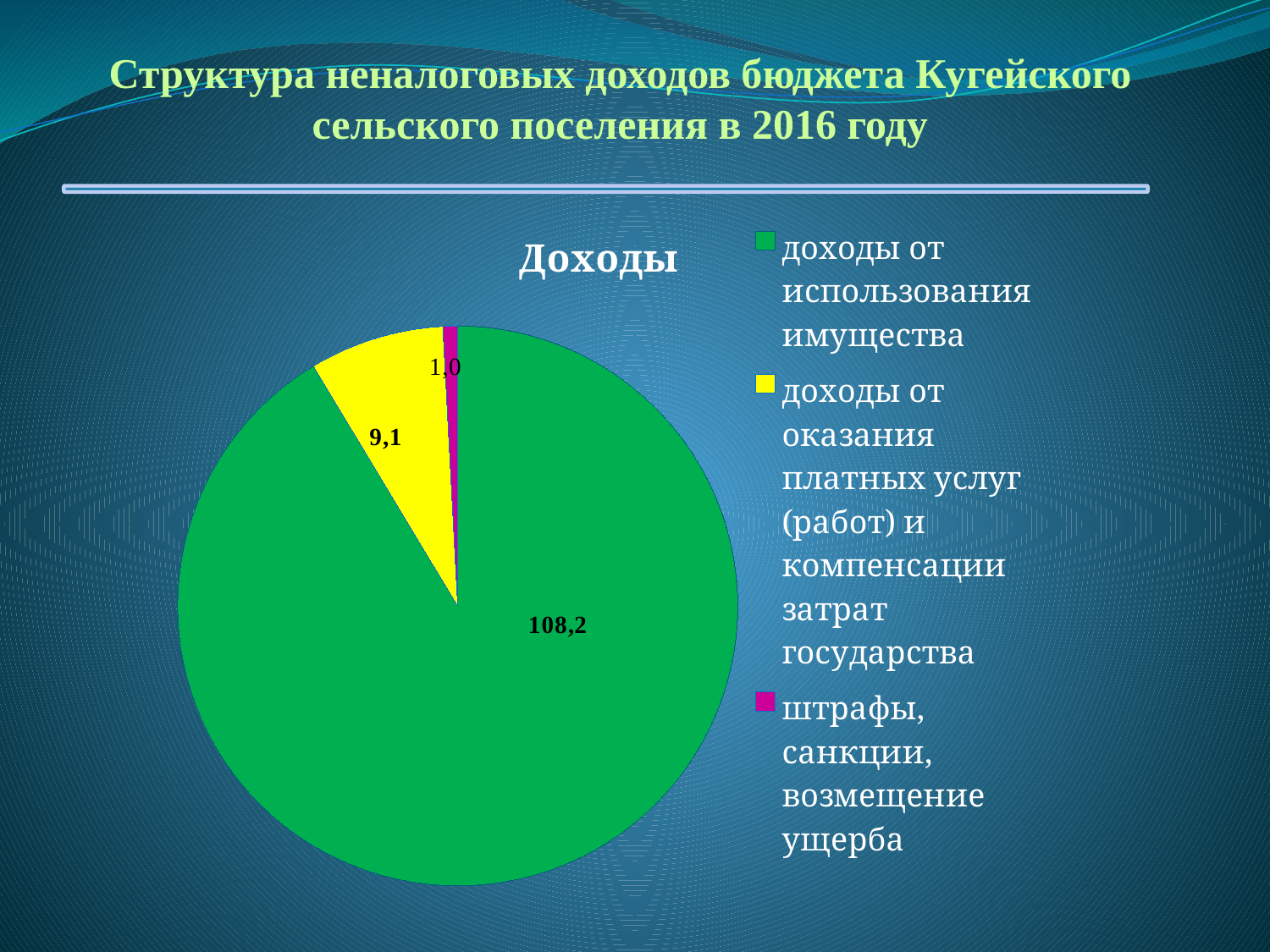
How many slices does the pie chart have? 3 Which category has the smallest slice of the pie? штрафы, санкции, возмещение ущерба What is the title of the chart? Доходы What is the value for "доходы от использования имущества"? 108,2 What is the difference between the value for "доходы от использования имущества" and the value for "доходы от оказания платных услуг (работ) и компенсации затрат государства"? 99,1 What type of chart is shown on the slide? pie chart How many entries does the legend list? 3 Which is larger: the value for "доходы от оказания платных услуг (работ) и компенсации затрат государства" or the value for "штрафы, санкции, возмещение ущерба"? доходы от оказания платных услуг (работ) и компенсации затрат государства What is the value for "доходы от оказания платных услуг (работ) и компенсации затрат государства"? 9,1 What is the value for "штрафы, санкции, возмещение ущерба"? 1,0 Which category has the largest slice of the pie? доходы от использования имущества What colour is the slice for "штрафы, санкции, возмещение ущерба"? magenta